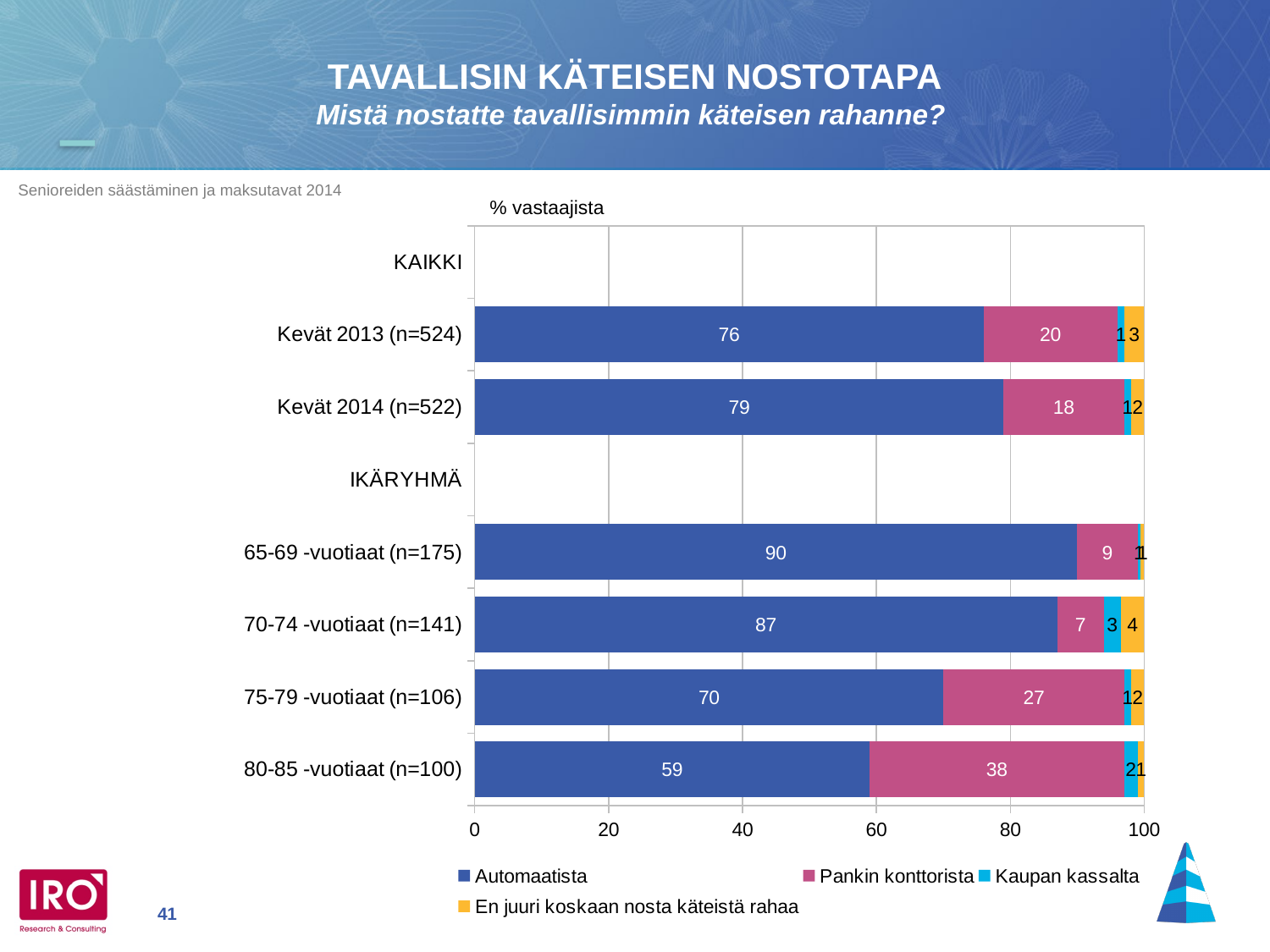
What is the Pankin konttorista value for 80-85 -vuotiaat (n=100)? 38 What is the label on the x axis of the chart? % vastaajista Which age group has the highest Automaatista value? 65-69 -vuotiaat (n=175) How many bars with data are plotted in the chart? 6 What is the Automaatista value for 65-69 -vuotiaat (n=175)? 90 Which is larger, the Pankin konttorista value for 75-79 -vuotiaat (n=106) or for 70-74 -vuotiaat (n=141)? 75-79 -vuotiaat (n=106) Is the Automaatista value for 80-85 -vuotiaat (n=100) greater or less than 60? less What kind of chart is shown on the slide? Stacked bar chart What is the Automaatista value for Kevät 2014 (n=522)? 79 How many series does the legend list? 4 What is the difference between the Automaatista values for Kevät 2014 (n=522) and Kevät 2013 (n=524)? 3 Which age group has the lowest Automaatista value? 80-85 -vuotiaat (n=100)